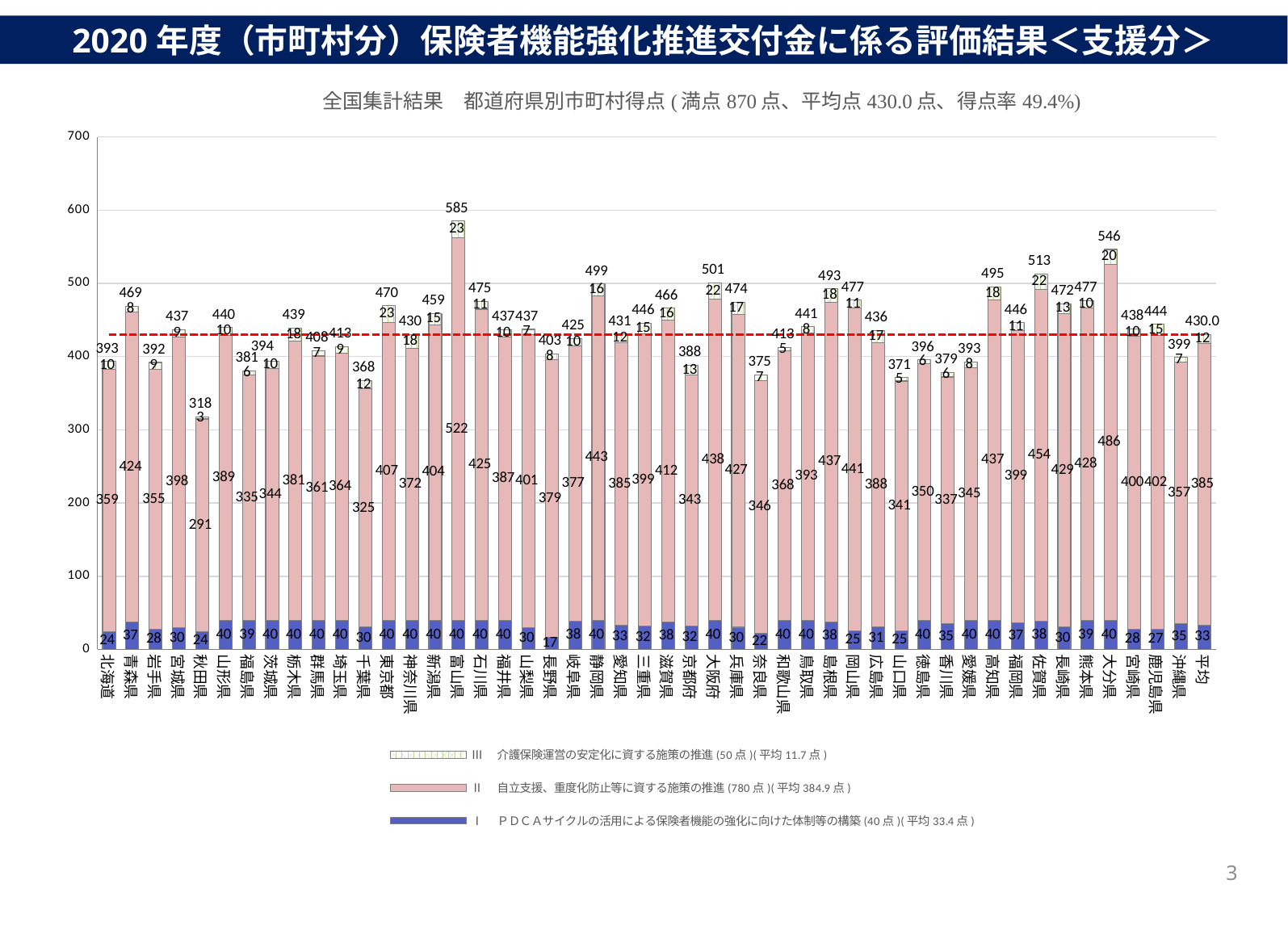
Which prefecture has the lowest total score? 秋田県 Which has a higher total score, 東京都 or 千葉県? 東京都 What is the value of series I (blue segment) for 長野県? 17 What kind of chart is shown on the slide? stacked bar chart What is the total score for 大分県? 546 Is the total score for 秋田県 greater or less than 400? less What is the value of series II (pink segment) for 富山県? 522 What is the total score shown for 平均 (the average bar)? 430.0 How many series does the legend list? 3 Which prefecture has the highest total score? 富山県 What is the difference between the total score of 富山県 and that of 秋田県? 267 What is the value of series III for 東京都? 23